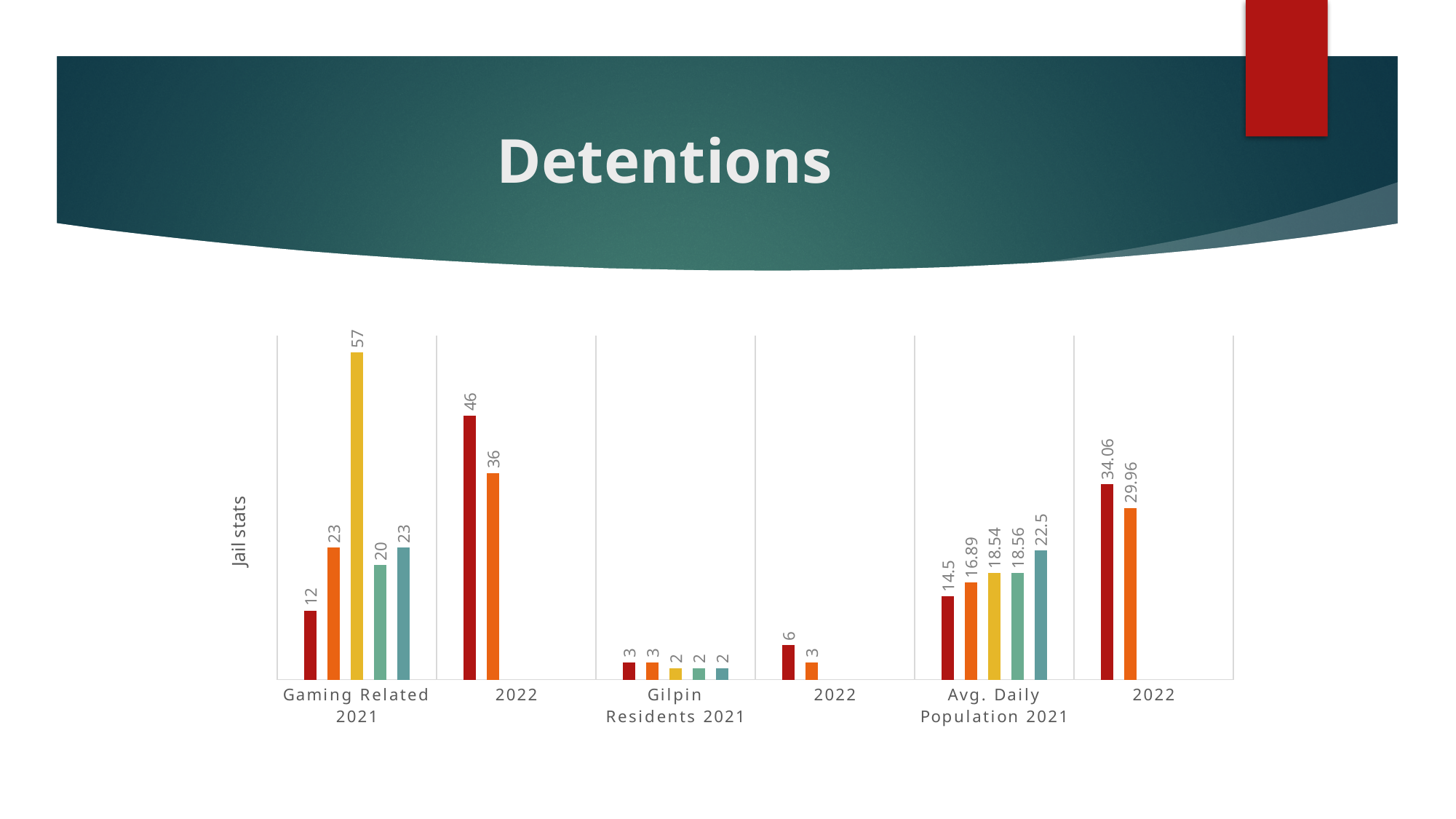
What is the label on the vertical axis of the chart? Jail stats Which is larger: the first bar in the Gaming Related 2021 group or the first bar in the adjacent 2022 group? the 2022 bar What is the difference between the two bars in the 2022 group next to Gaming Related 2021? 10 What is the value of the tallest bar in the Gaming Related 2021 group? 57 What is the value of the second (orange) bar in the 2022 group next to Gaming Related 2021? 36 What is the value of the first (dark red) bar in the 2022 group next to Avg. Daily Population 2021? 34.06 What is the value of the first (dark red) bar in the 2022 group next to Gilpin Residents 2021? 6 How many category groups are shown along the x axis? 6 What is the value of the first (dark red) bar in the Gaming Related 2021 group? 12 What is the value of the first (dark red) bar in the 2022 group next to Gaming Related 2021? 46 What kind of chart is shown on the slide? bar chart What is the value of the last (teal) bar in the Avg. Daily Population 2021 group? 22.5